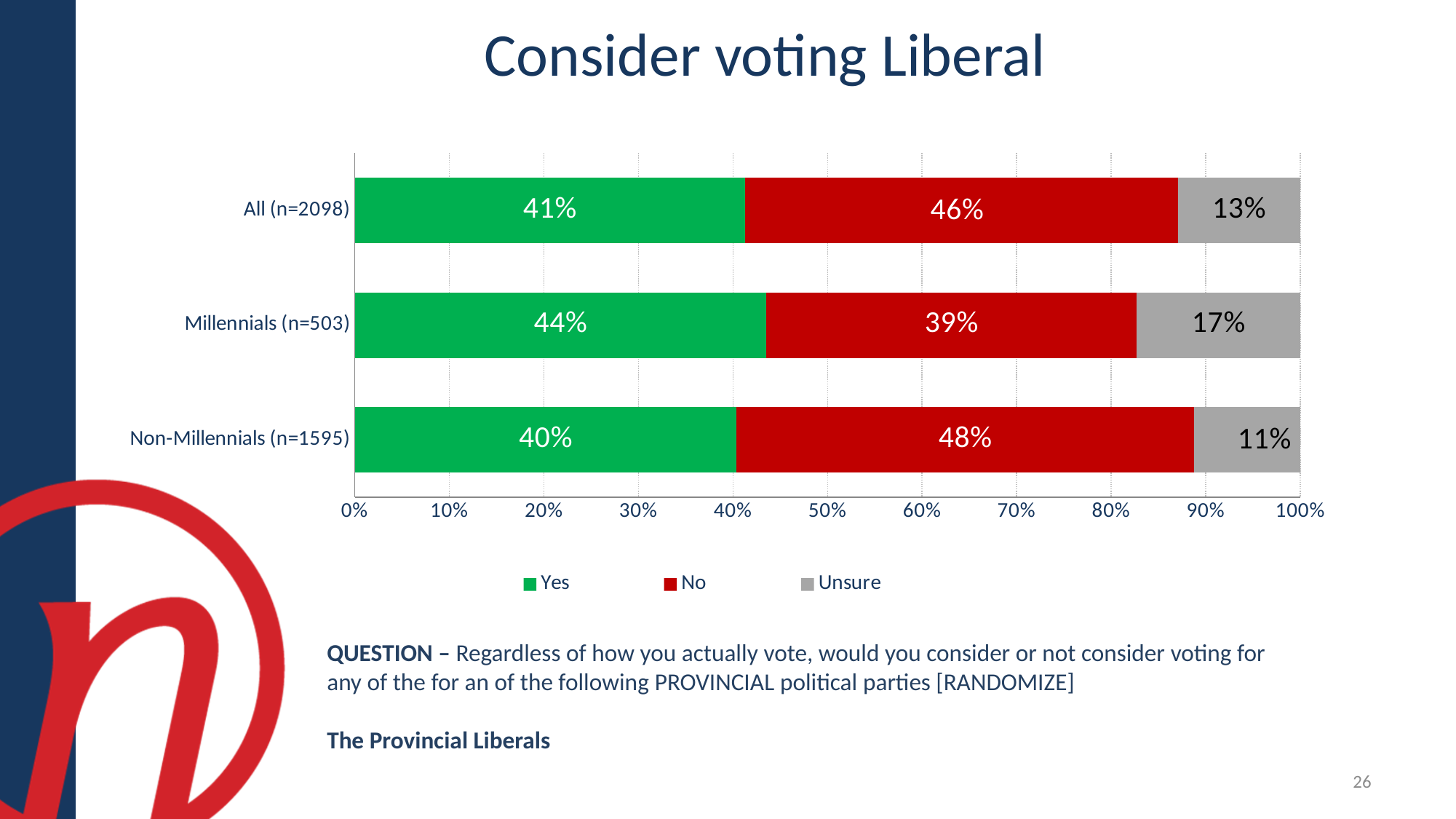
Which group has the highest Yes percentage? Millennials (n=503) What percentage of Non-Millennials (n=1595) answered Unsure? 11% Which is larger for Millennials (n=503): the Yes percentage or the No percentage? Yes What is the difference between the No percentage for Non-Millennials (n=1595) and Millennials (n=503)? 9% What percentage of All (n=2098) answered Yes? 41% What percentage of Millennials (n=503) answered No? 39% What is the title of the chart? Consider voting Liberal What kind of chart is shown on the slide? Stacked bar chart How many series does the legend list? 3 Which group has the lowest Unsure percentage? Non-Millennials (n=1595) How many groups are shown on the chart? 3 What is the total of the Yes, No and Unsure values for All (n=2098)? 100%